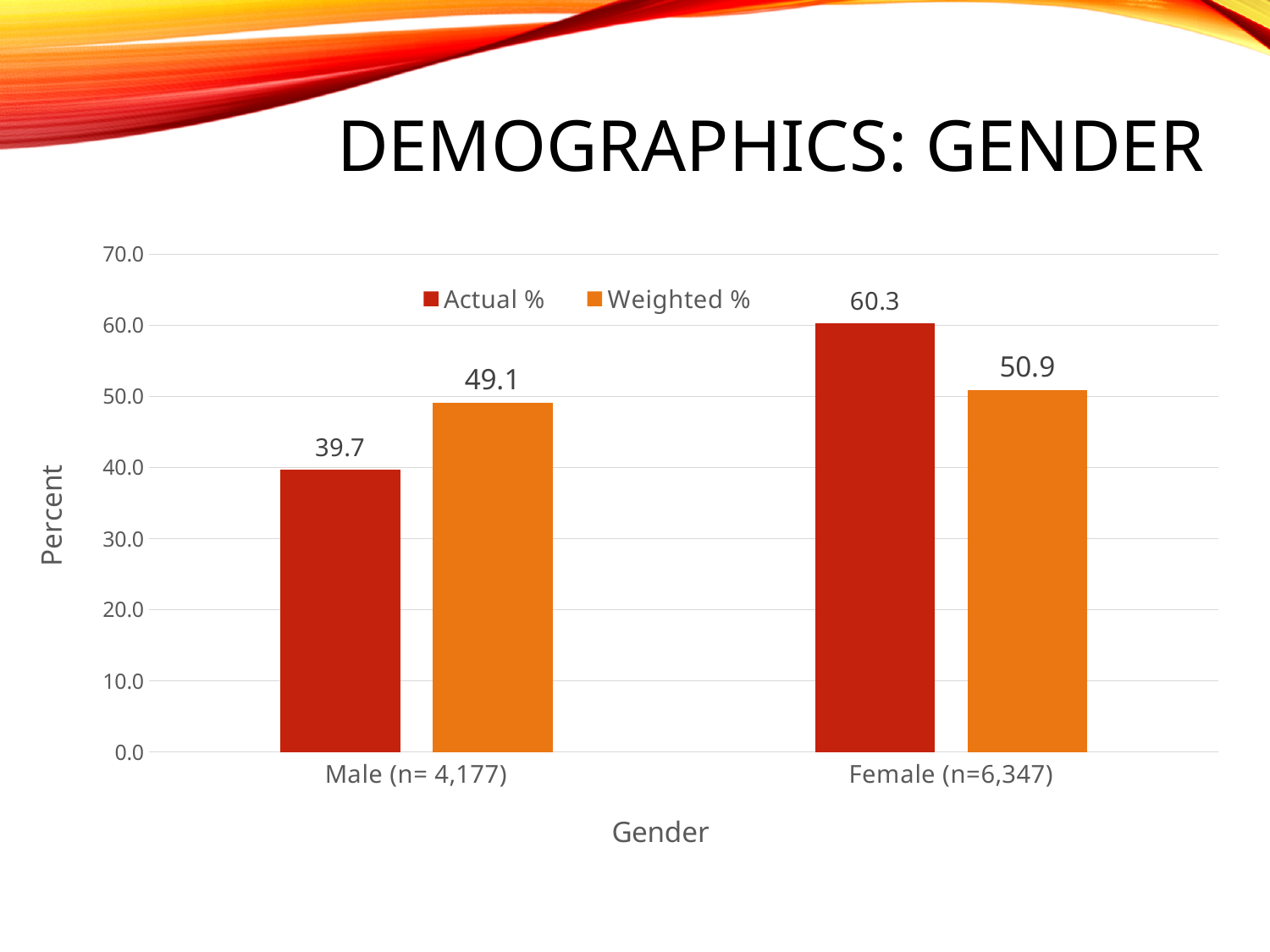
What is the difference between the Actual % values for Female and Male? 20.6 What is the Actual % value for Male (n= 4,177)? 39.7 Which category has the highest Actual % value? Female (n=6,347) Which is larger for Female (n=6,347): the Actual % or the Weighted %? Actual % What is the Actual % value for Female (n=6,347)? 60.3 What is the Weighted % value for Male (n= 4,177)? 49.1 What kind of chart is shown on the slide? Bar chart What is the Weighted % value for Female (n=6,347)? 50.9 What is the difference between the Actual % and Weighted % values for Male (n= 4,177)? 9.4 How many series does the legend list? 2 Which category has the lowest Weighted % value? Male (n= 4,177) What is the label of the vertical axis? Percent